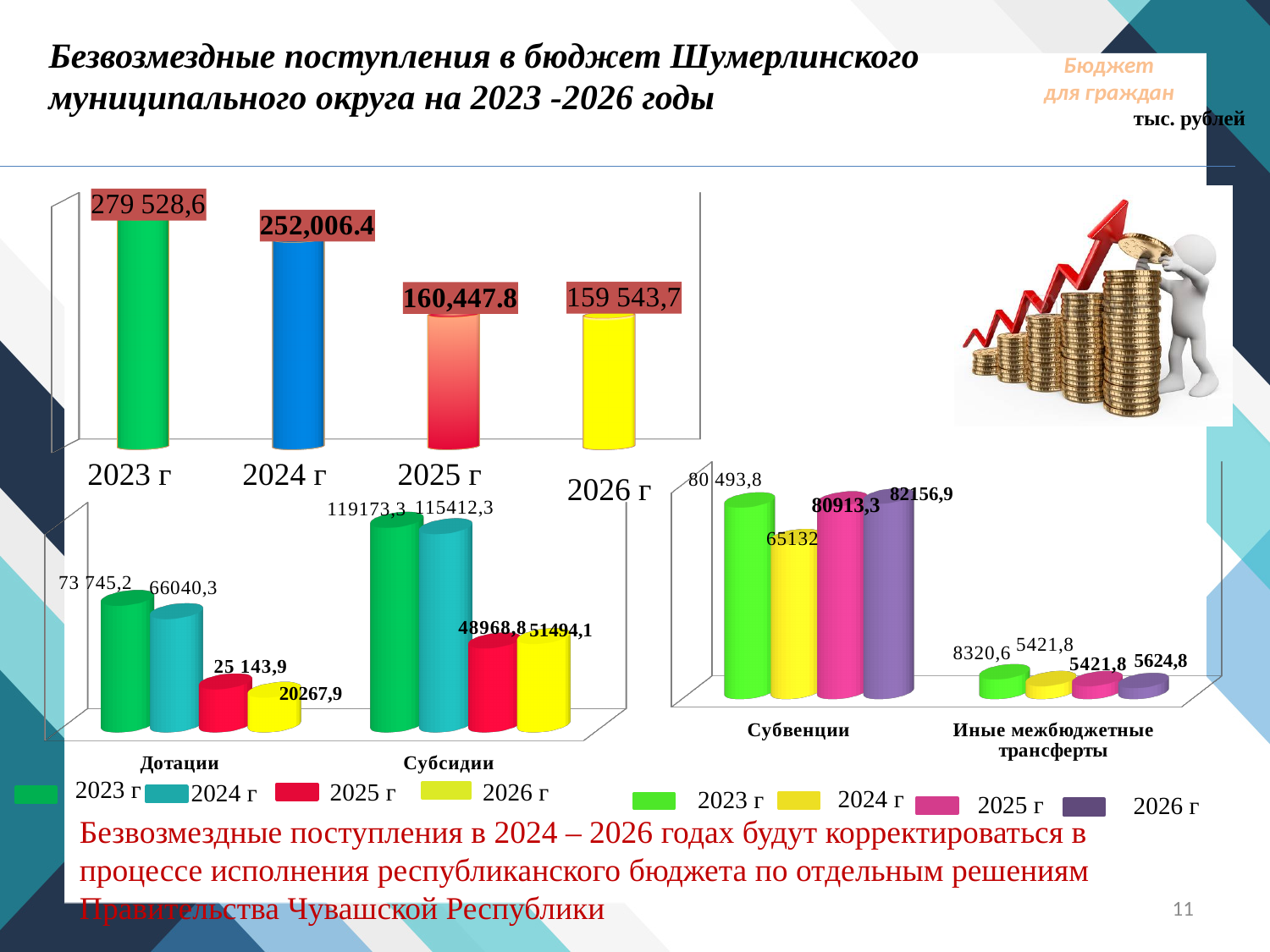
In the bottom-left chart, what is the difference between Субсидии in 2023 г and 2024 г? 3761 In the top chart, what is the value for 2025 г? 160,447.8 How many bars are in the top chart? 4 How many series does the legend of the bottom-left chart list? 4 In the top chart, which year has the highest value? 2023 г In the top chart, which year has the lowest value? 2026 г In the bottom-left chart, what is the value for Дотации in 2024 г? 66040,3 In the bottom-right chart, what is the value for Субвенции in 2024 г? 65132 In the bottom-left chart, which is larger for Субсидии: 2025 г or 2026 г? 2026 г In the top chart, what is the value for 2023 г? 279 528,6 In the bottom-right chart, which year has the highest value for Иные межбюджетные трансферты? 2023 г In the top chart, do the values rise or fall from 2023 г to 2026 г? fall